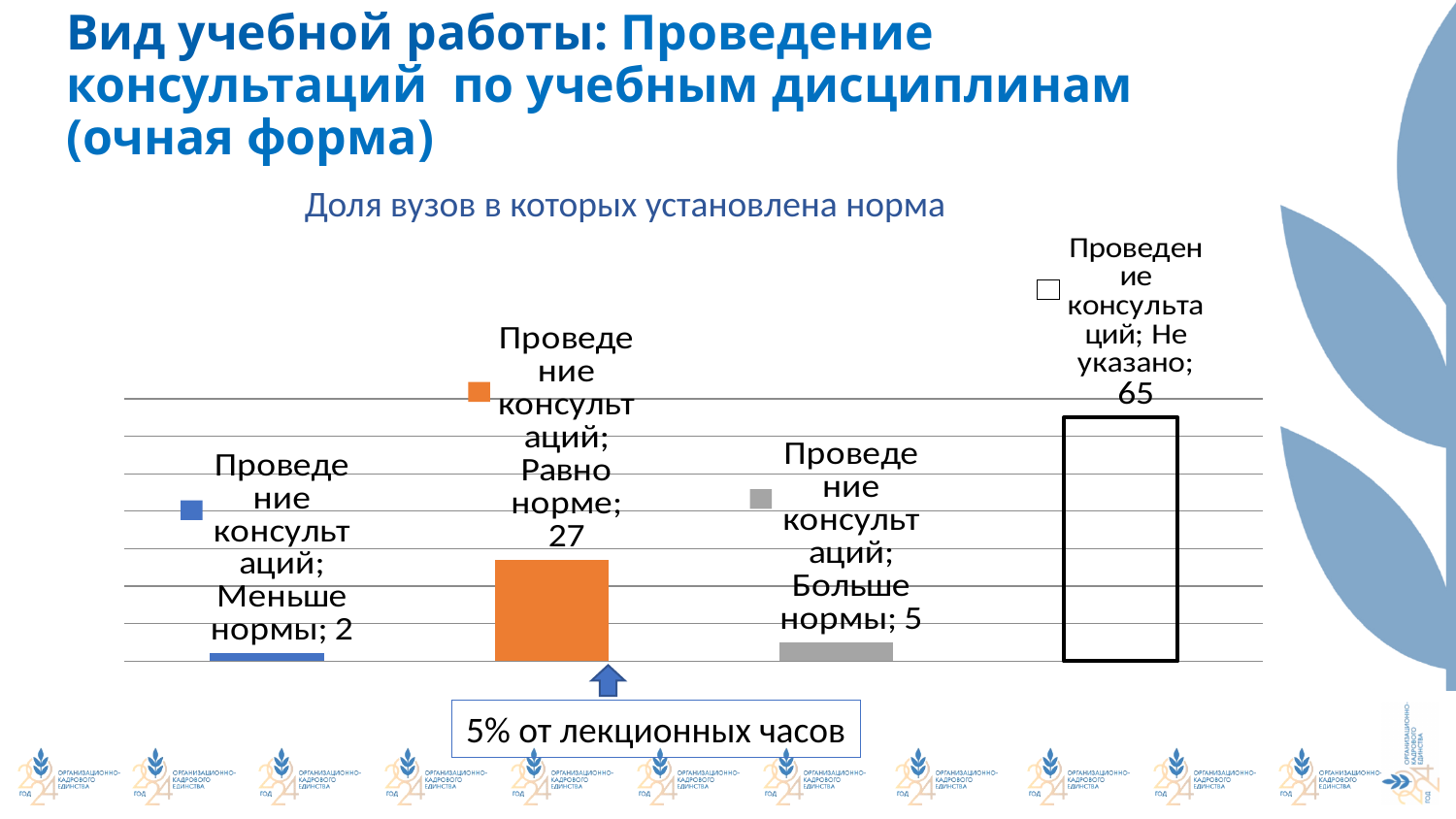
What is the value for "Равно норме" in the chart? 27 Which is larger: the value for "Равно норме" or the value for "Больше нормы"? Равно норме Which category has the lowest value in the chart? Меньше нормы What is the difference between the values for "Не указано" and "Равно норме"? 38 What is the value for "Больше нормы" in the chart? 5 What kind of chart is shown on the slide? bar chart How many categories are plotted in the chart? 4 What is the title of the chart? Доля вузов в которых установлена норма What is the difference between the values for "Больше нормы" and "Меньше нормы"? 3 What is the value for "Меньше нормы" in the chart? 2 Which category has the highest value in the chart? Не указано What is the value for "Не указано" in the chart? 65